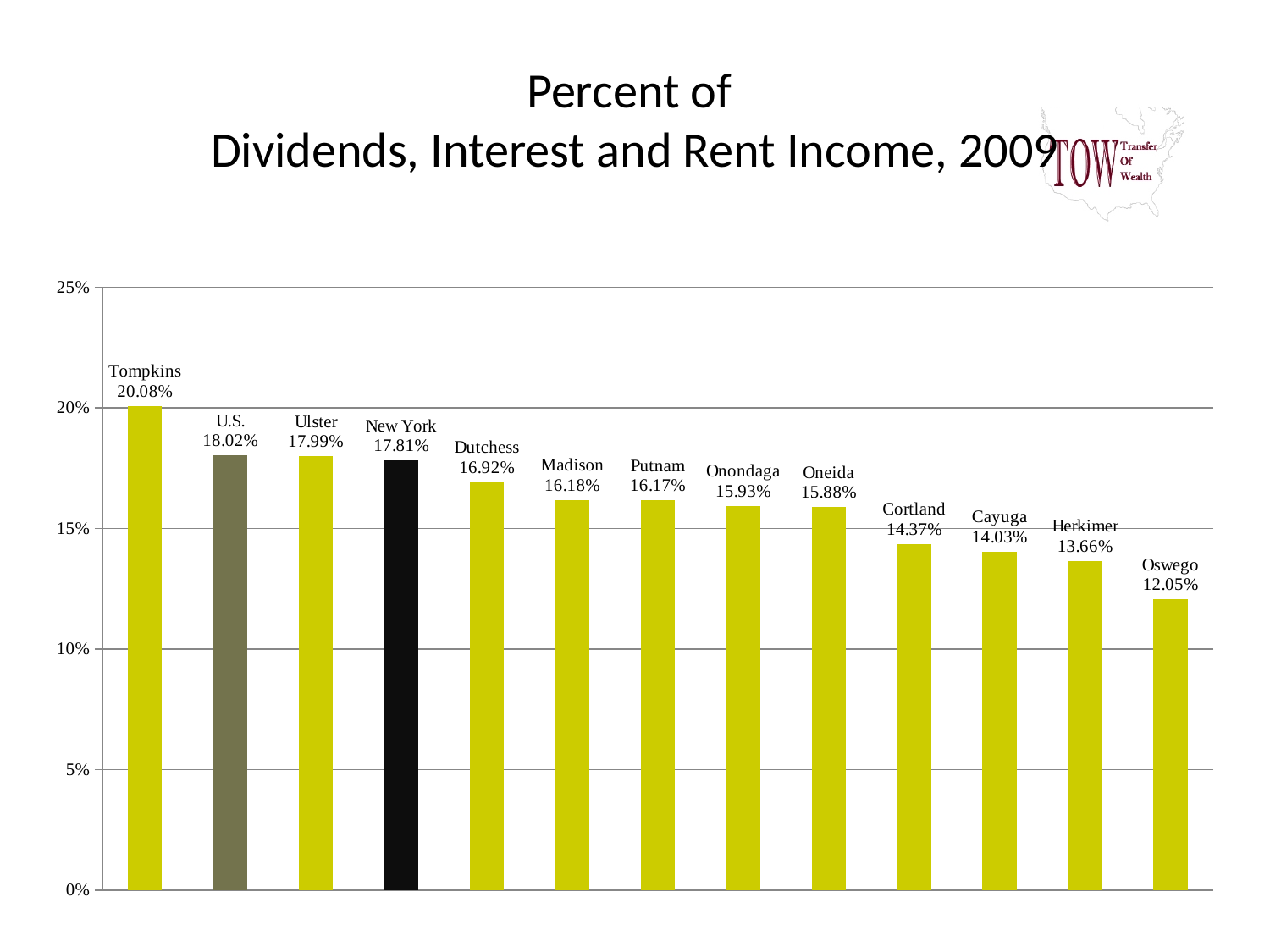
What is the difference between the values for Tompkins and Oswego? 8.03% Do the values rise or fall from left to right along the x axis? fall What is the difference between the values for U.S. and New York? 0.21% What is the value for Tompkins? 20.08% How many bars are shown in the chart? 13 Which category has the highest value? Tompkins Which category has the lowest value? Oswego What kind of chart is shown on the slide? bar chart Is the value for Herkimer greater or less than 15%? less What is the value for Oneida? 15.88% What is the value for New York? 17.81% Which is larger, the value for Dutchess or the value for Cortland? Dutchess